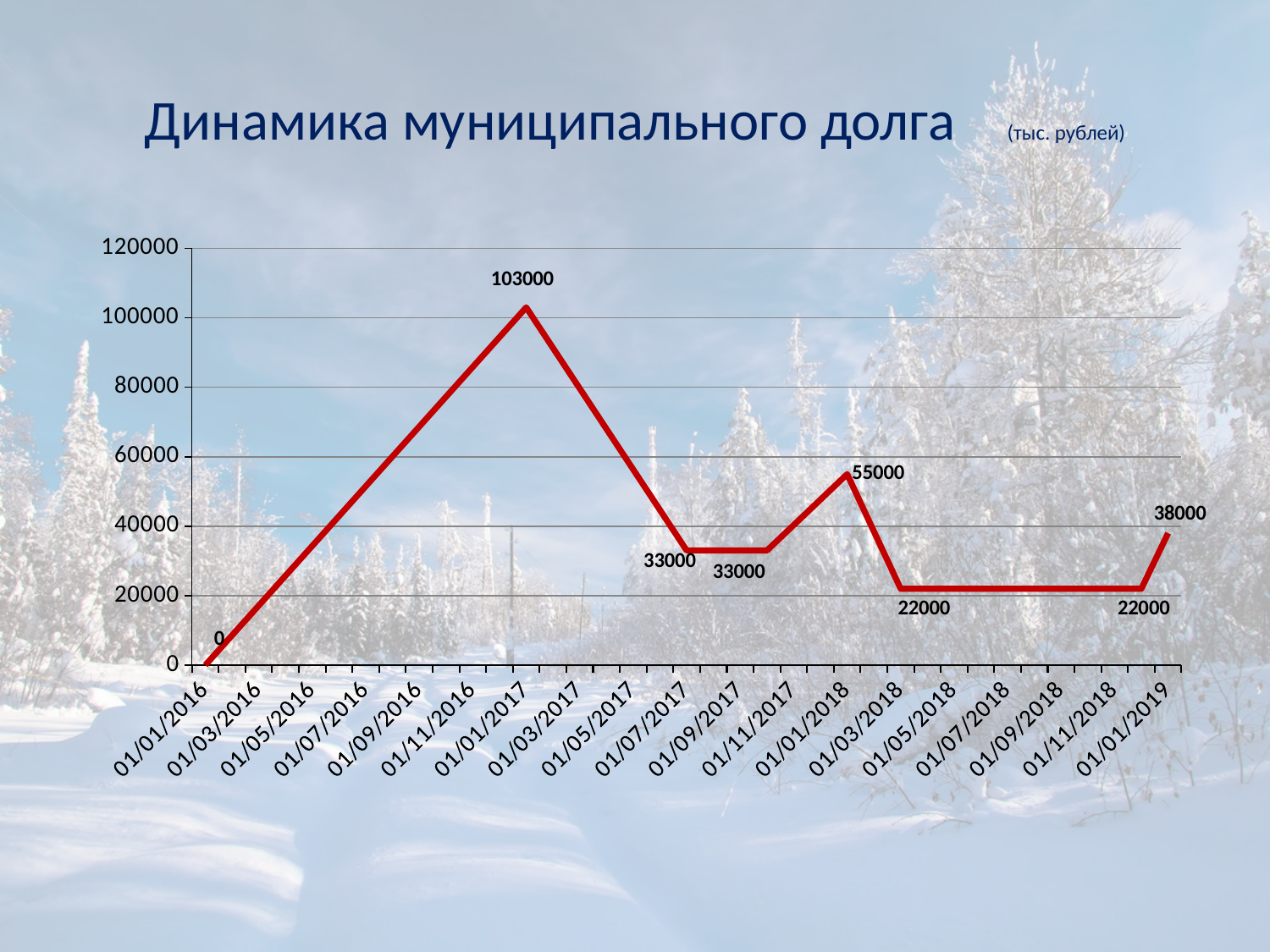
What is the highest value shown on the chart? 103000 What is the value of municipal debt on 01/01/2018? 55000 On which date does the municipal debt reach its highest value? 01/01/2017 What is the value of municipal debt on 01/01/2019? 38000 What kind of chart is shown on the slide? line chart What is the difference between the value on 01/01/2019 and the value on 01/11/2018? 16000 What is the value of municipal debt on 01/01/2017? 103000 What is the value of municipal debt on 01/01/2016? 0 Which is larger, the value on 01/01/2018 or the value on 01/01/2019? 01/01/2018 What is the difference between the value on 01/01/2017 and the value on 01/01/2018? 48000 Does the municipal debt rise or fall between 01/01/2016 and 01/01/2017? rise Is the value on 01/01/2017 greater or less than 100000? greater